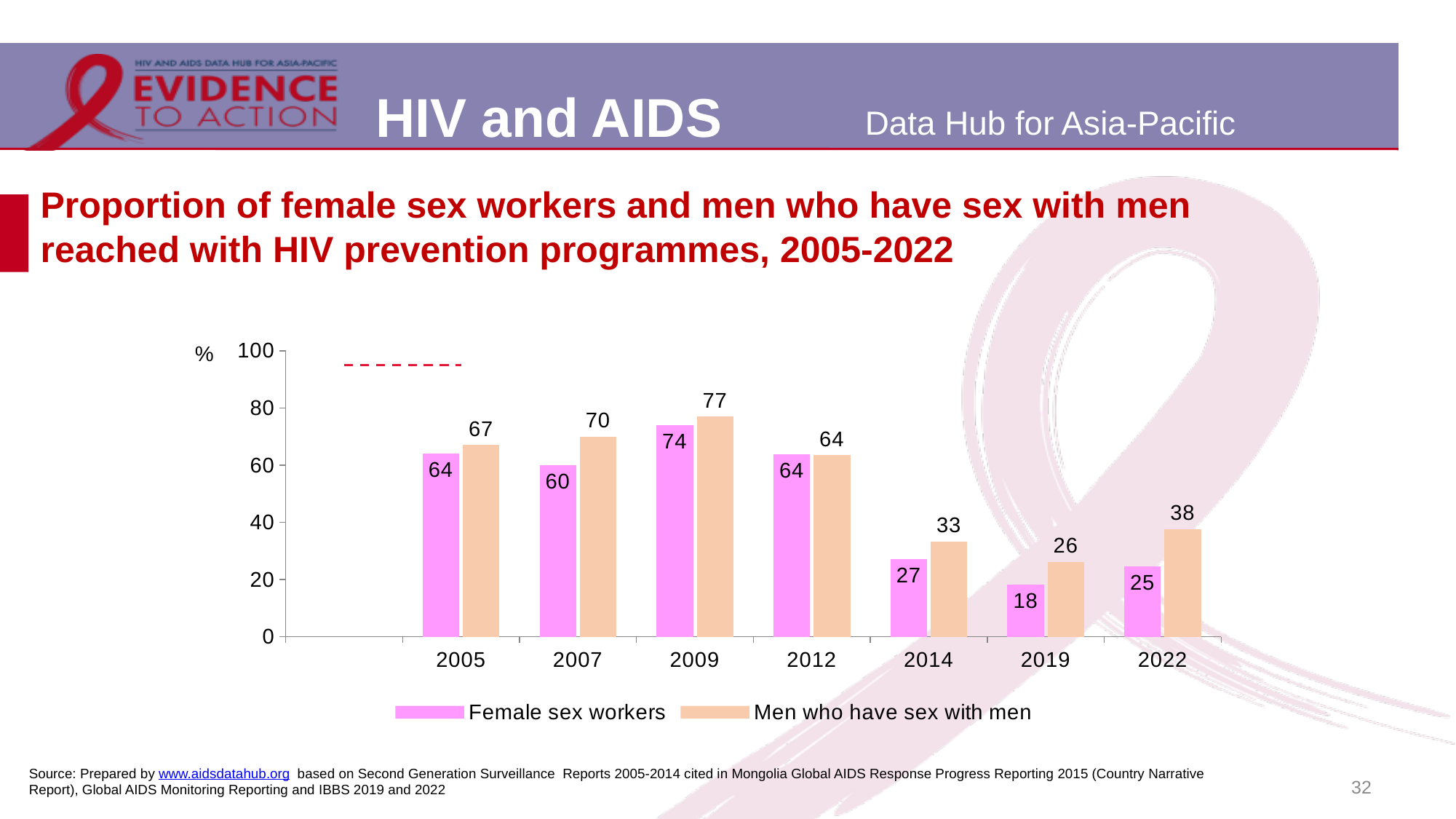
What colour are the bars for Female sex workers? Pink How many years are shown on the x axis? 7 What is the value for Female sex workers in 2019? 18 What is the value for Female sex workers in 2009? 74 Do the values for Female sex workers rise or fall from 2012 to 2019? Fall Which is larger in 2007: the value for Female sex workers or for Men who have sex with men? Men who have sex with men In which year is the value for Men who have sex with men highest? 2009 In which year is the value for Female sex workers lowest? 2019 What is the value for Men who have sex with men in 2022? 38 How many series does the legend list? 2 What kind of chart is shown on the slide? Bar chart What is the difference between the Men who have sex with men value and the Female sex workers value in 2014? 6